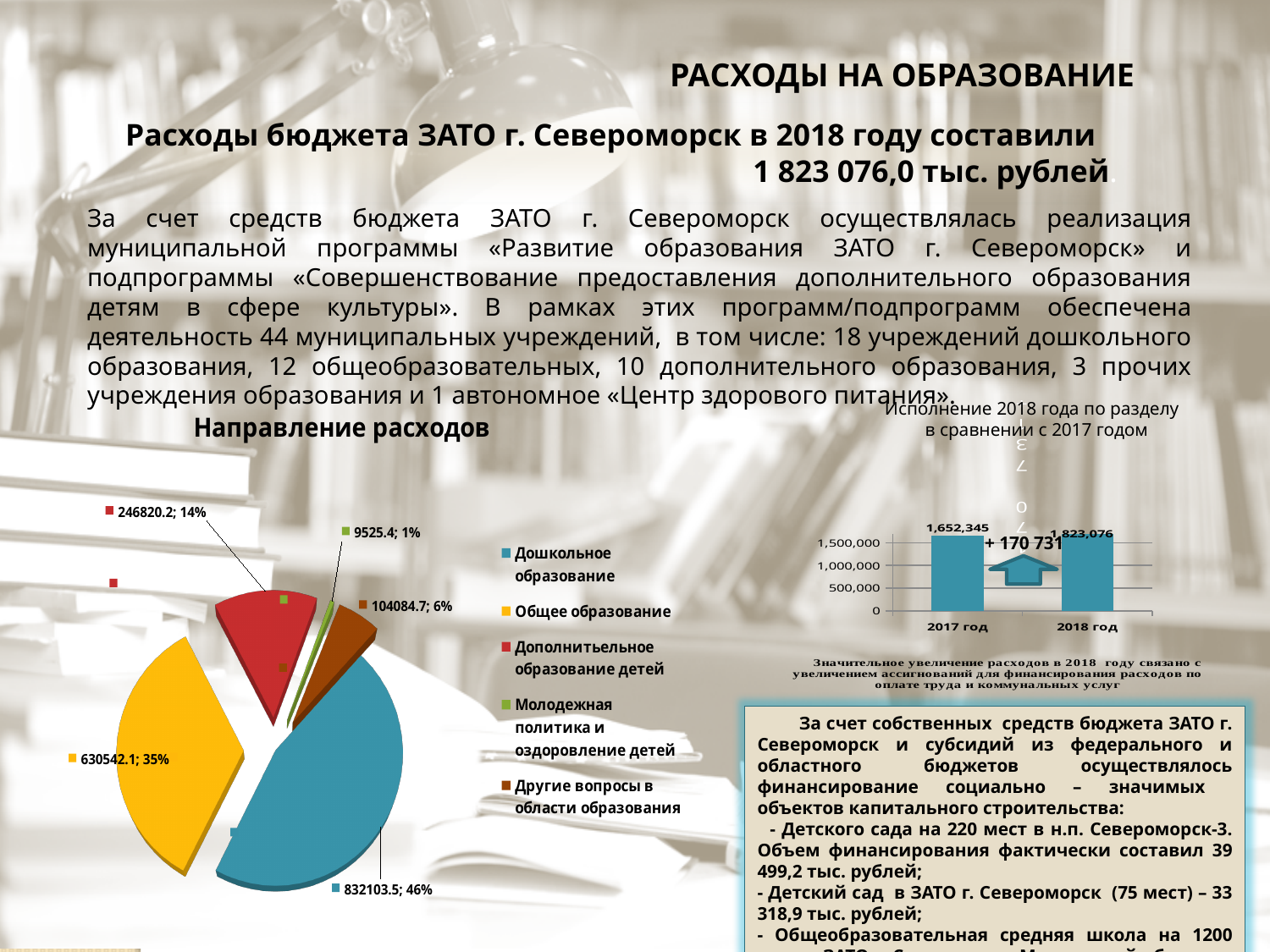
On the pie chart 'Направление расходов', what value and share are shown for Дошкольное образование? 832103.5; 46% On the pie chart 'Направление расходов', which is larger: Общее образование or Дополнительное образование детей? Общее образование On the bar chart 'Исполнение 2018 года по разделу в сравнении с 2017 годом', do the values rise or fall from 2017 год to 2018 год? rise On the pie chart 'Направление расходов', what value and share are shown for Общее образование? 630542.1; 35% On the pie chart 'Направление расходов', what share does Дополнительное образование детей have? 14% On the pie chart 'Направление расходов', what is the value for Другие вопросы в области образования? 104084.7 On the bar chart 'Исполнение 2018 года по разделу в сравнении с 2017 годом', what is the value for 2017 год? 1,652,345 On the bar chart 'Исполнение 2018 года по разделу в сравнении с 2017 годом', what is the value for 2018 год? 1,823,076 On the pie chart 'Направление расходов', how many categories does the legend list? 5 On the pie chart 'Направление расходов', which category has the smallest slice? Молодежная политика и оздоровление детей On the pie chart 'Направление расходов', which category has the largest slice? Дошкольное образование On the bar chart 'Исполнение 2018 года по разделу в сравнении с 2017 годом', what kind of chart is it? bar chart